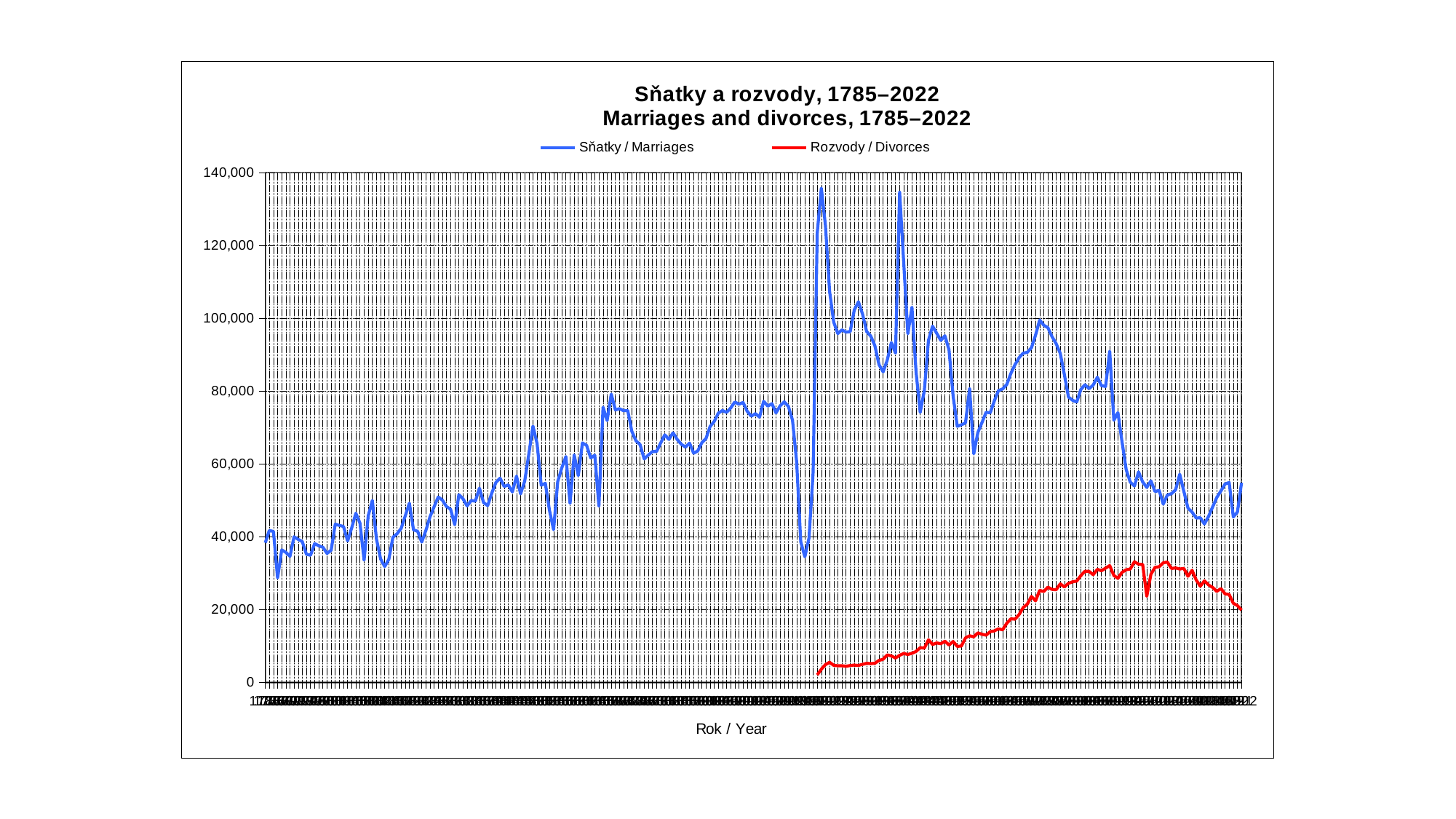
Which series starts later along the x axis, Sňatky / Marriages or Rozvody / Divorces? Rozvody / Divorces What is the title of the chart? Sňatky a rozvody, 1785–2022 / Marriages and divorces, 1785–2022 Which series reaches the higher peak value, Sňatky / Marriages or Rozvody / Divorces? Sňatky / Marriages Which series is drawn in red? Rozvody / Divorces What kind of chart is shown on the slide? line chart How many series does the legend list? 2 What is the label of the x axis? Rok / Year Is the highest value of the Rozvody / Divorces series greater or less than 40,000? less Is the highest value of the Sňatky / Marriages series greater or less than 120,000? greater Does the Rozvody / Divorces series generally rise or fall from its first point to its peak? rise Is the lowest value of the Sňatky / Marriages series greater or less than 20,000? greater